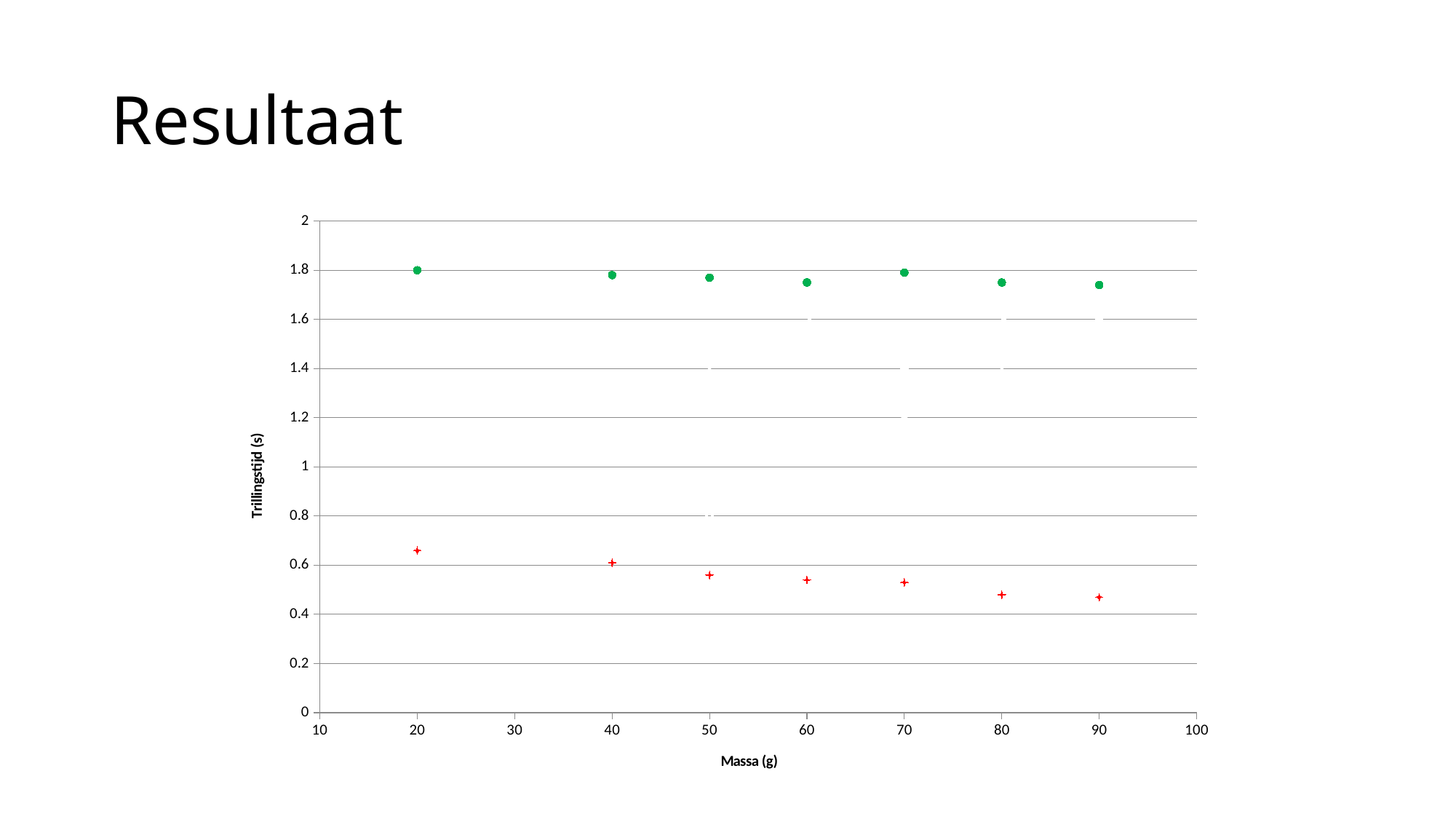
What is the title of the x axis? Massa (g) Is the value of the green dot at a mass of 20 g greater or less than 1.6? greater What is the title of the y axis? Trillingstijd (s) Is the value of the red cross at a mass of 90 g greater or less than 0.6? less Is the value of the red cross at a mass of 20 g greater or less than 0.6? greater How many green dot points are plotted on the chart? 7 At which mass is the red cross value highest? 20 How many red cross points are plotted on the chart? 7 At a mass of 50 g, which is higher: the green dot or the red cross? the green dot What kind of chart is shown on the slide? scatter chart Do the red cross values rise or fall as the mass increases along the x axis? fall